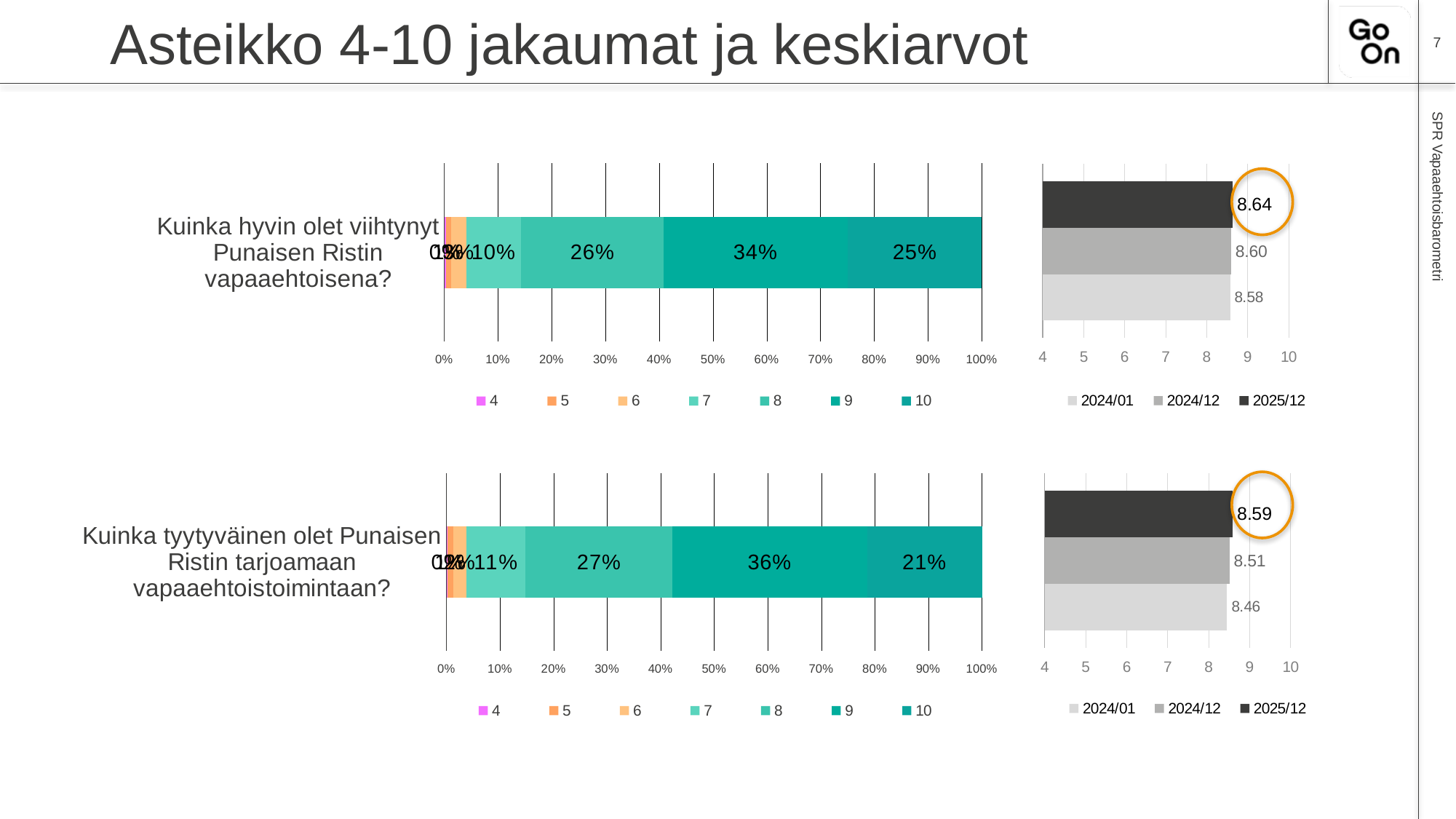
In the top-right average chart, what is the difference between the 2025/12 value and the 2024/12 value? 0.04 In the top-right average chart, do the values rise or fall from 2024/01 to 2025/12? rise In the bottom-right average chart, what is the difference between the 2025/12 value and the 2024/01 value? 0.13 In the top-right average chart (next to 'Kuinka hyvin olet viihtynyt Punaisen Ristin vapaaehtoisena?'), what is the value for 2025/12? 8.64 In the top-left stacked bar chart ('Kuinka hyvin olet viihtynyt Punaisen Ristin vapaaehtoisena?'), what percentage is shown for the score 9 segment? 34% In the bottom-right average chart, which period has the lowest value? 2024/01 In the top-right average chart, what is the value for 2024/01? 8.58 In the top-left stacked bar chart, is the share for score 8 larger or smaller than the share for score 10? larger In the bottom-right average chart (next to 'Kuinka tyytyväinen olet Punaisen Ristin tarjoamaan vapaaehtoistoimintaan?'), what is the value for 2024/12? 8.51 In the bottom-left stacked bar chart ('Kuinka tyytyväinen olet Punaisen Ristin tarjoamaan vapaaehtoistoimintaan?'), what percentage is shown for the score 10 segment? 21% How many series does the legend of the top-left stacked bar chart list? 7 In the bottom-left stacked bar chart, which score has the largest share? 9